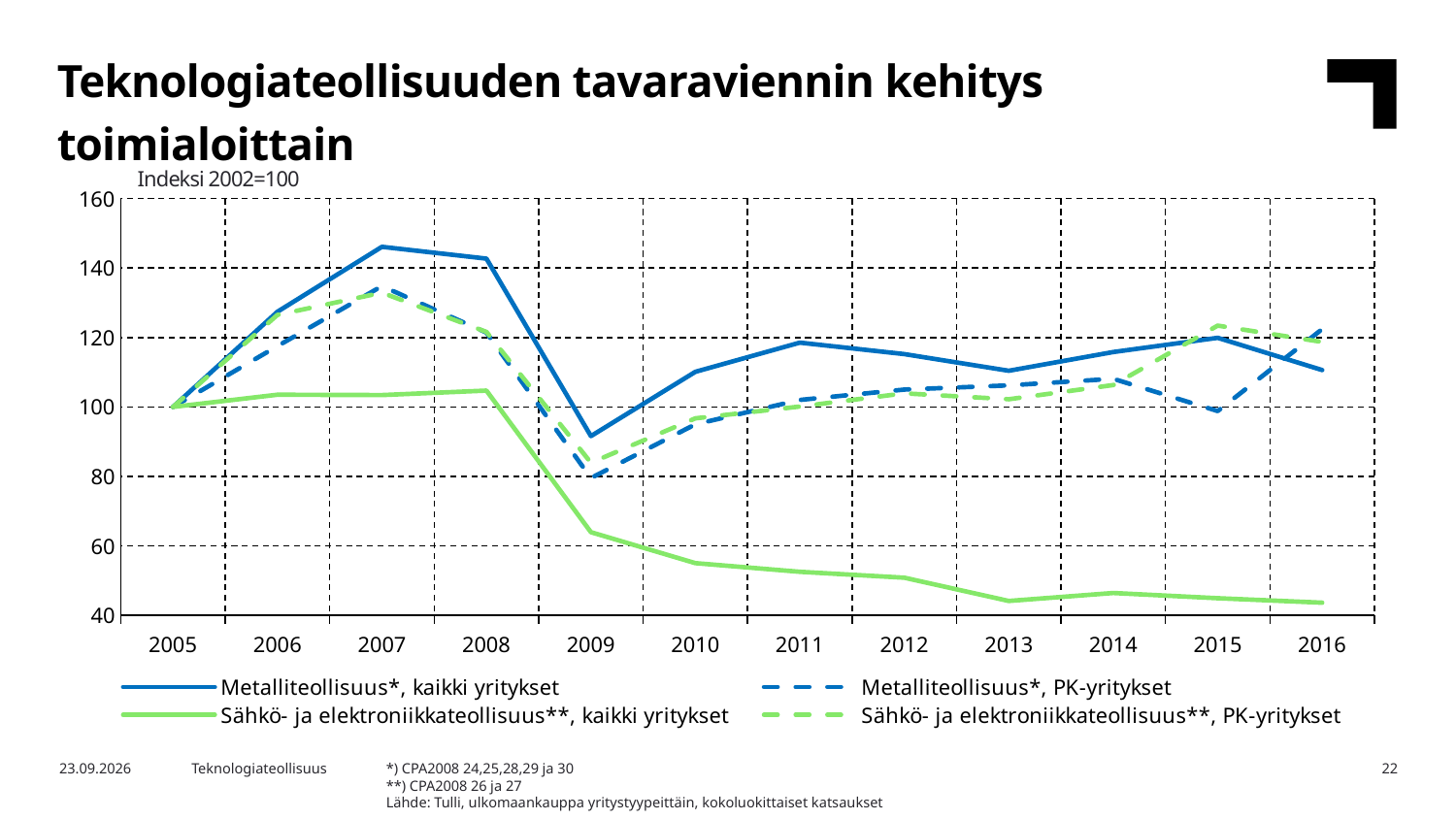
Is the value for Sähkö- ja elektroniikkateollisuus**, kaikki yritykset in 2016 greater or less than 60? less What kind of chart is shown on the slide? line chart Is the value for Sähkö- ja elektroniikkateollisuus**, kaikki yritykset in 2009 greater or less than 80? less How many years are shown along the x axis? 12 Is the value for Metalliteollisuus*, kaikki yritykset in 2009 greater or less than 100? less Does the Sähkö- ja elektroniikkateollisuus**, kaikki yritykset series rise or fall from 2008 to 2016? fall What index base is stated above the y axis? Indeksi 2002=100 In 2016, which is larger: Metalliteollisuus*, kaikki yritykset or Sähkö- ja elektroniikkateollisuus**, kaikki yritykset? Metalliteollisuus*, kaikki yritykset In which year does Metalliteollisuus*, kaikki yritykset reach its highest value? 2007 What is the value of Metalliteollisuus*, kaikki yritykset in 2005? 100 How many series does the legend list? 4